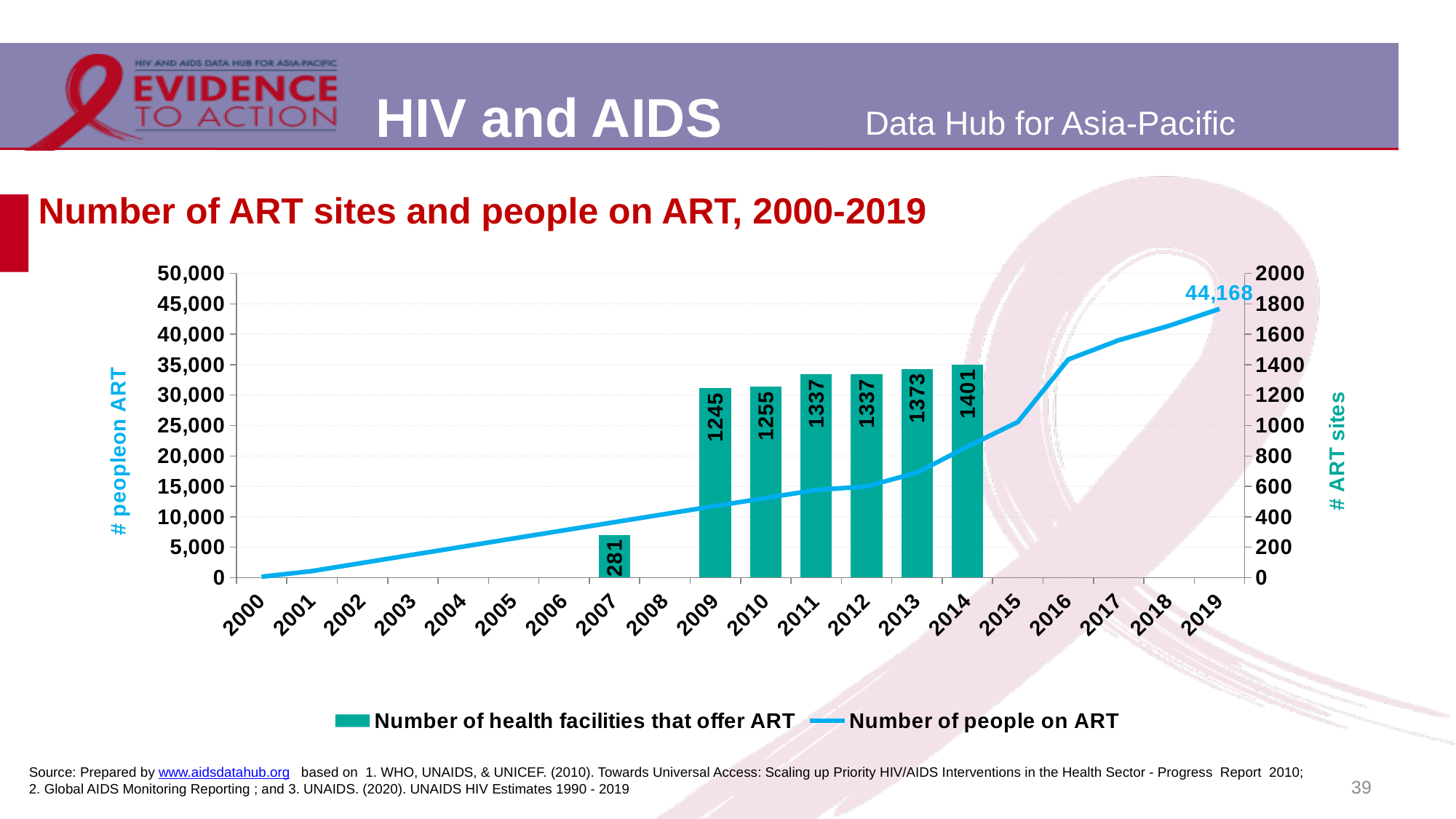
Which is larger, the number of health facilities that offer ART in 2010 or in 2013? 2013 What is the number of health facilities that offer ART in 2007? 281 What is the number of health facilities that offer ART in 2014? 1401 What is the difference between the number of health facilities that offer ART in 2009 and in 2007? 964 How many series does the legend list? 2 Is the number of people on ART in 2008 greater or less than 15,000? less Which year has the highest labelled number of health facilities that offer ART? 2014 Is the number of people on ART in 2016 greater or less than 30,000? greater What is the number of people on ART in 2019? 44,168 What is the difference between the number of health facilities that offer ART in 2014 and in 2013? 28 Does the number of people on ART rise or fall from 2000 to 2019? rise Which year has the lowest labelled number of health facilities that offer ART? 2007